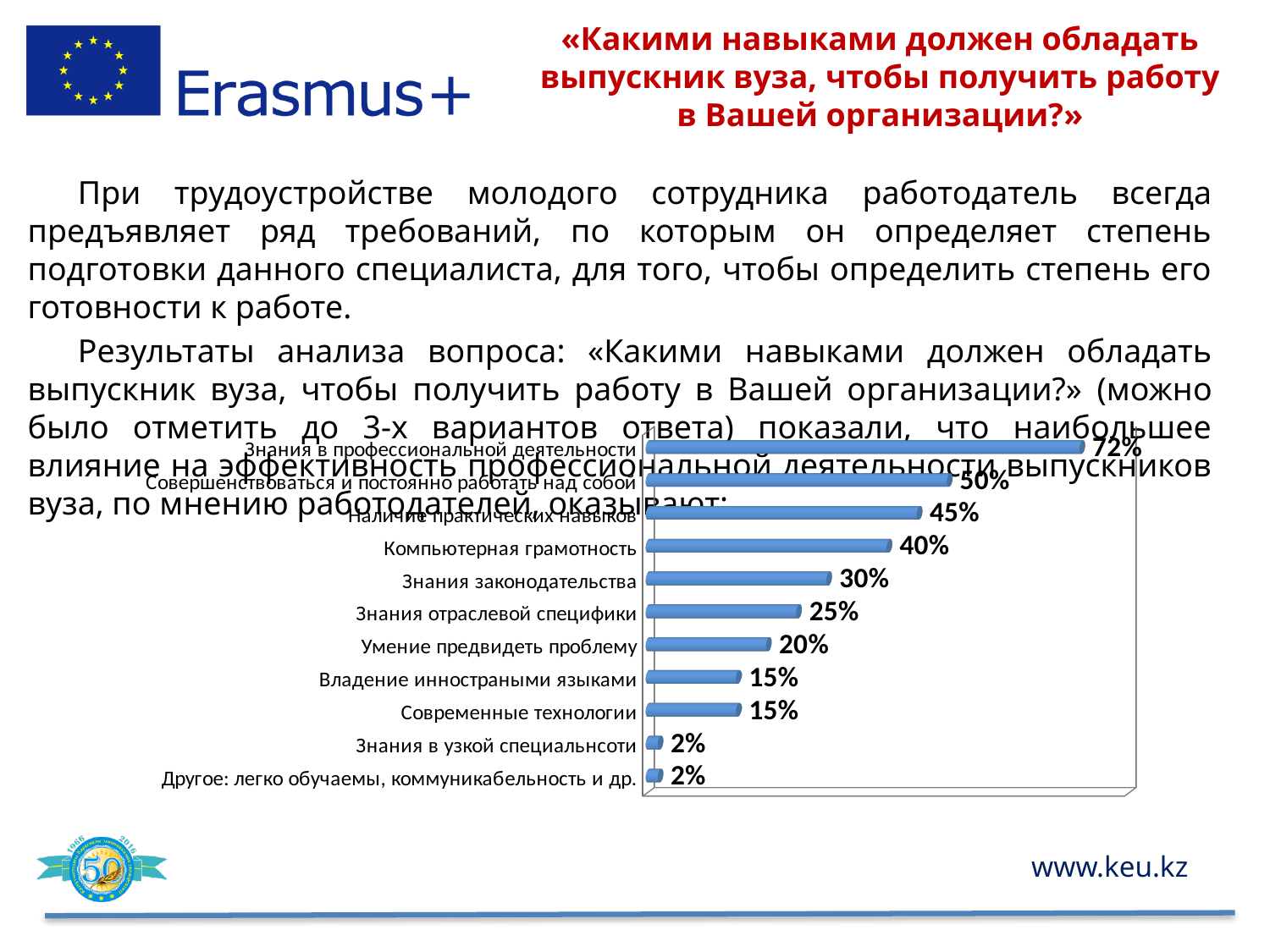
What kind of chart is shown on the slide? bar chart What is the value for Знания законодательства? 30% Which is larger, the value for Знания отраслевой специфики or the value for Знания законодательства? Знания законодательства What is the value for Современные технологии? 15% What is the value for Наличие практических навыков? 45% What is the value for Компьютерная грамотность? 40% What is the value for Знания в узкой специальнсоти? 2% What is the difference between the values for Компьютерная грамотность and Умение предвидеть проблему? 20% Which category has the highest value in the chart? Знания в профессиональной деятельности What is the difference between the values for Знания в профессиональной деятельности and Совершенствоваться и постоянно работать над собой? 22% What is the value for Умение предвидеть проблему? 20% How many categories does the bar chart show? 11